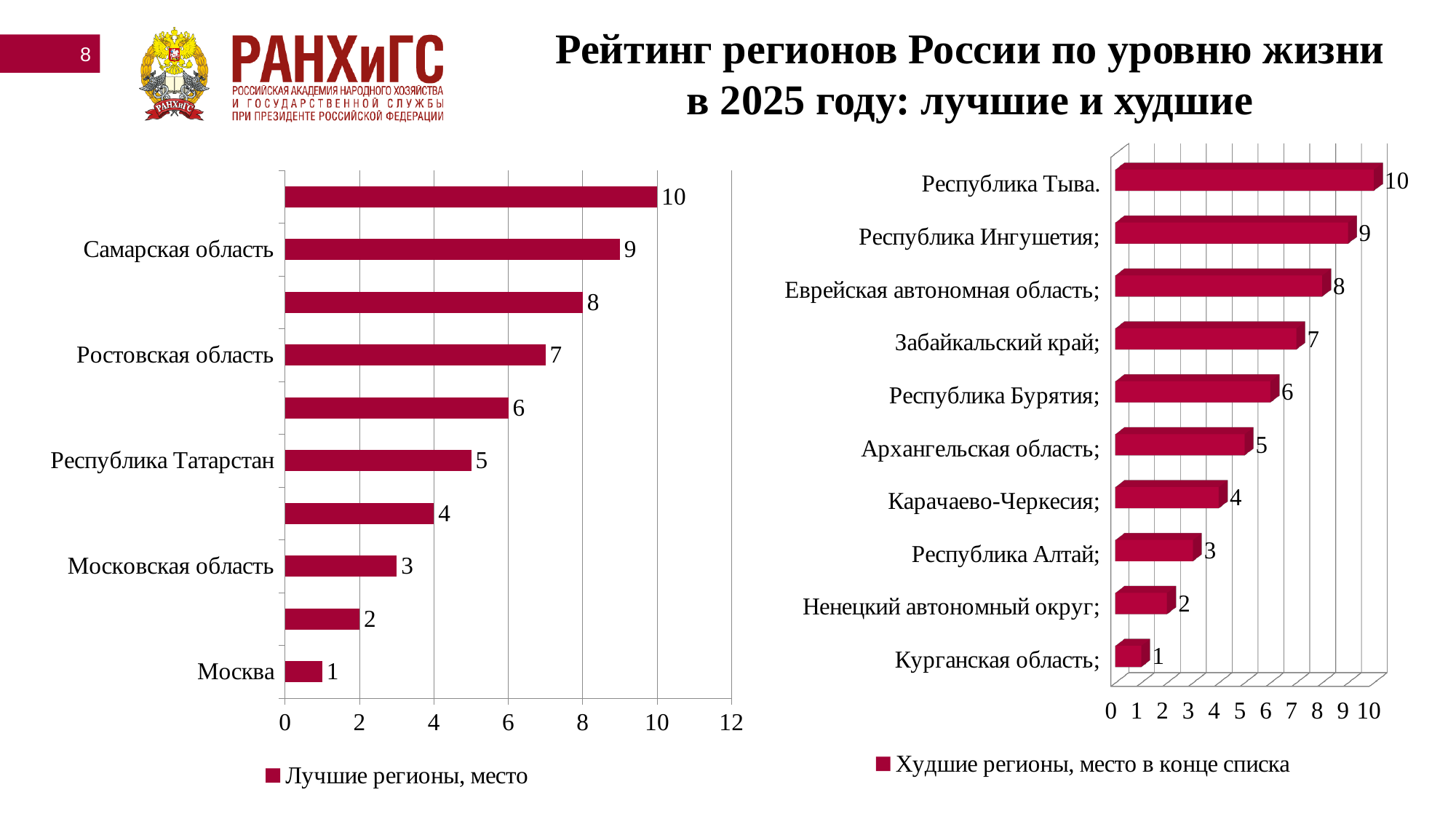
What is the legend entry of the right chart? Худшие регионы, место в конце списка In the left chart (Лучшие регионы, место), what is the value for Республика Татарстан? 5 In the right chart (Худшие регионы, место в конце списка), what is the difference between the values for Республика Ингушетия and Республика Алтай? 6 What kind of chart is the left chart (Лучшие регионы, место)? Bar chart In the right chart (Худшие регионы, место в конце списка), what is the value for Ненецкий автономный округ? 2 In the right chart (Худшие регионы, место в конце списка), which region has the lowest value? Курганская область In the right chart (Худшие регионы, место в конце списка), which region has the highest value? Республика Тыва In the left chart (Лучшие регионы, место), which is larger: the value for Ростовская область or the value for Московская область? Ростовская область In the left chart (Лучшие регионы, место), what is the value for Самарская область? 9 How many bars are there in the right chart (Худшие регионы, место в конце списка)? 10 In the left chart (Лучшие регионы, место), what is the value for Москва? 1 In the right chart (Худшие регионы, место в конце списка), what is the value for Республика Бурятия? 6